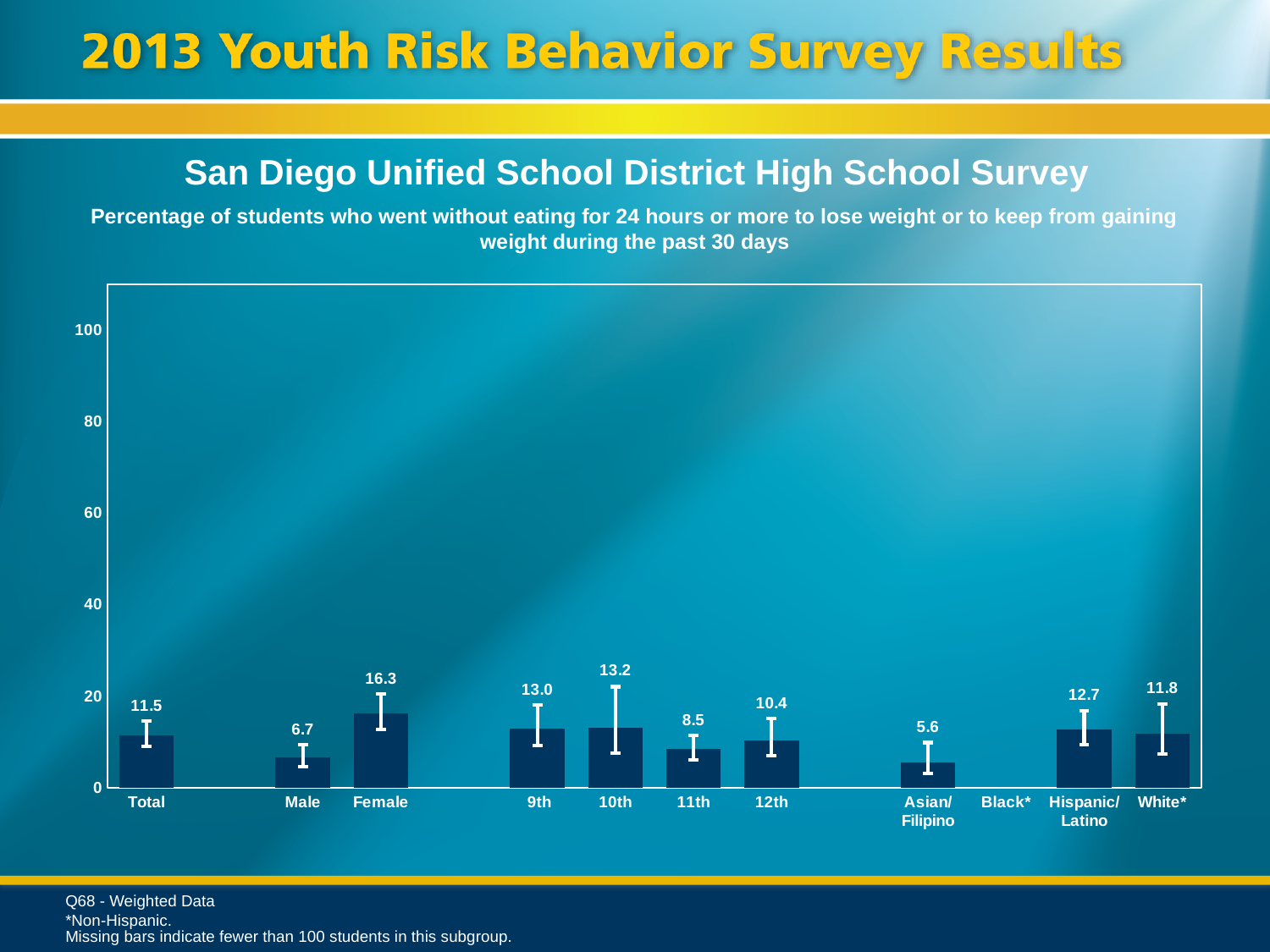
What is the value for 12th? 10.4 What is the difference between the Female and Male values? 9.6 What is the value for Asian/Filipino? 5.6 What is the value for Female? 16.3 How many categories have a bar plotted? 10 What kind of chart is shown? bar chart Is the value for Female greater or less than 20? less What is the value for Total? 11.5 Which category with a bar has the lowest value? Asian/Filipino Which category has the highest value? Female Which is larger, the value for 10th or the value for 11th? 10th Which category label has no bar plotted? Black*